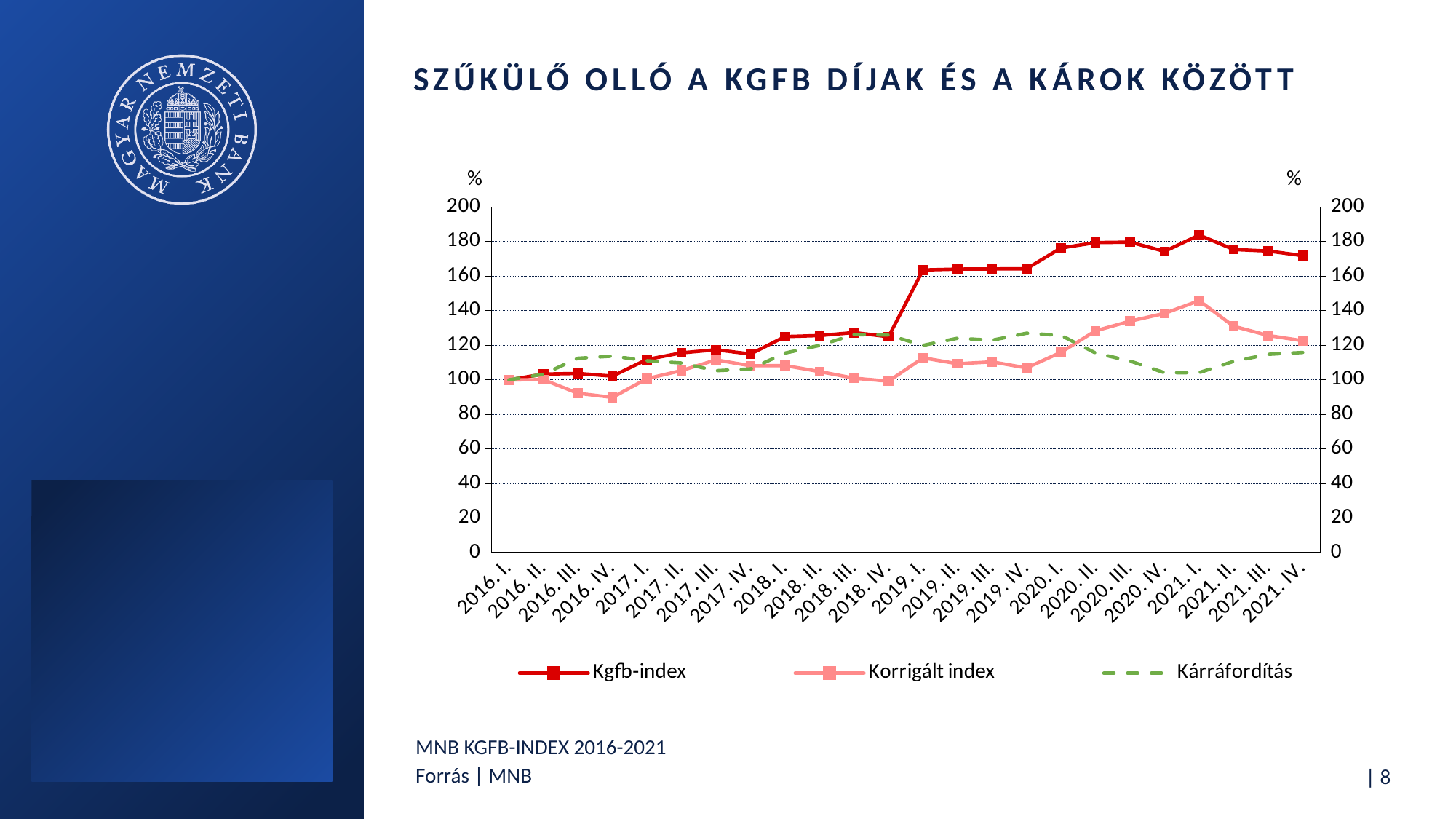
Is the value of the Kgfb-index in 2020. II. greater or less than 160? greater How many series does the legend list? 3 Is the value of the Korrigált index in 2016. IV. greater or less than 100? less In which quarter does the Korrigált index reach its highest value? 2021. I. What is the title of the slide? SZŰKÜLŐ OLLÓ A KGFB DÍJAK ÉS A KÁROK KÖZÖTT In which quarter does the Kgfb-index reach its highest value? 2021. I. How many quarterly points are plotted along the x axis? 24 In which quarter is the Korrigált index at its lowest? 2016. IV. Is the value of Kárráfordítás in 2020. IV. greater or less than 120? less In 2021. IV., which is higher: the Kgfb-index or the Korrigált index? Kgfb-index Does the Kgfb-index overall rise or fall from 2016. I. to 2021. IV.? rise What kind of chart is shown on the slide? line chart